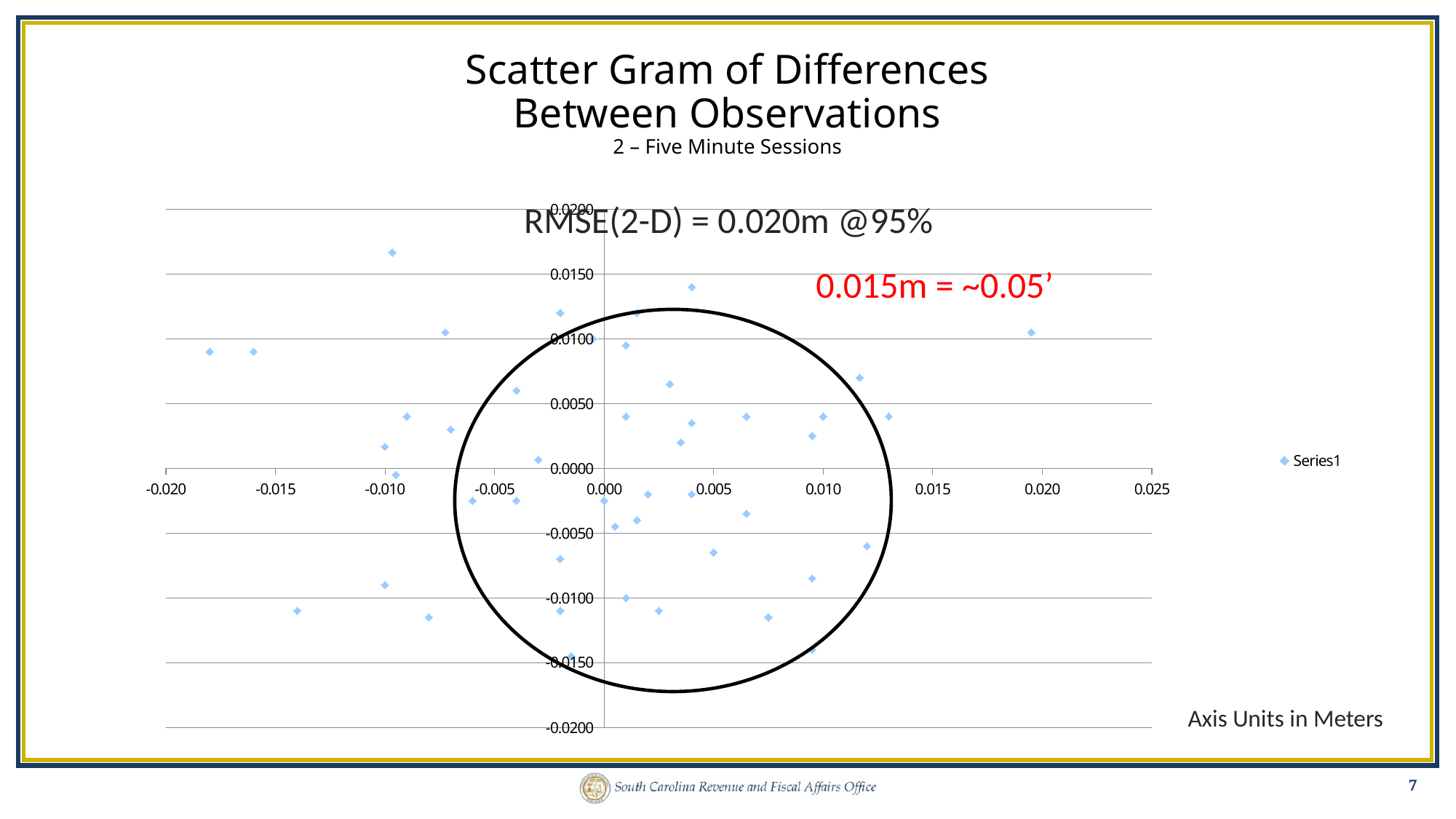
How many series does the legend list? 1 Is the y value of the highest plotted point greater or less than 0.0150? greater Is the x value of the rightmost plotted point greater or less than 0.015? greater According to the note on the slide, what units are the chart axes in? Meters What is the name of the series shown in the legend? Series1 What kind of chart is shown on the slide? scatter chart Is the x value of the leftmost plotted point greater or less than -0.015? less